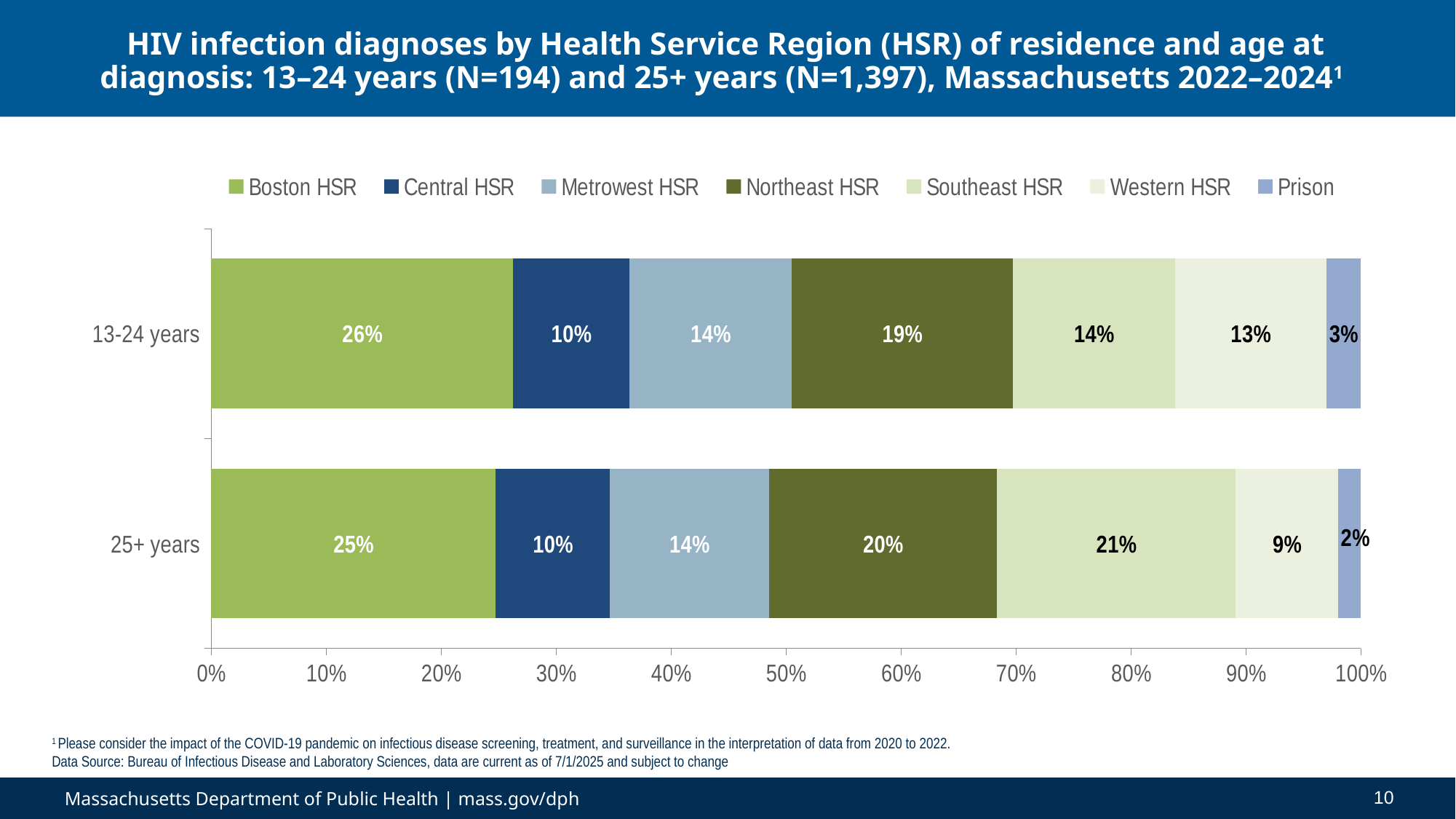
How many age groups are shown on the chart? 2 What is the difference between the Boston HSR and Central HSR shares in the 13-24 years bar? 16 percentage points What percentage of HIV diagnoses among 13-24 years were in Boston HSR? 26% How many percentage points higher is the Southeast HSR share for 25+ years than for 13-24 years? 7 percentage points Which segment is the smallest in the 25+ years bar? Prison What percentage of HIV diagnoses among 25+ years were in Southeast HSR? 21% Which age group has the larger Western HSR share, 13-24 years or 25+ years? 13-24 years What type of chart is shown on the slide? Stacked bar chart What is the Prison share for the 13-24 years bar? 3% Which region has the largest share of diagnoses among 13-24 years? Boston HSR How many series does the legend list? 8 What is the Northeast HSR value for the 25+ years bar? 20%